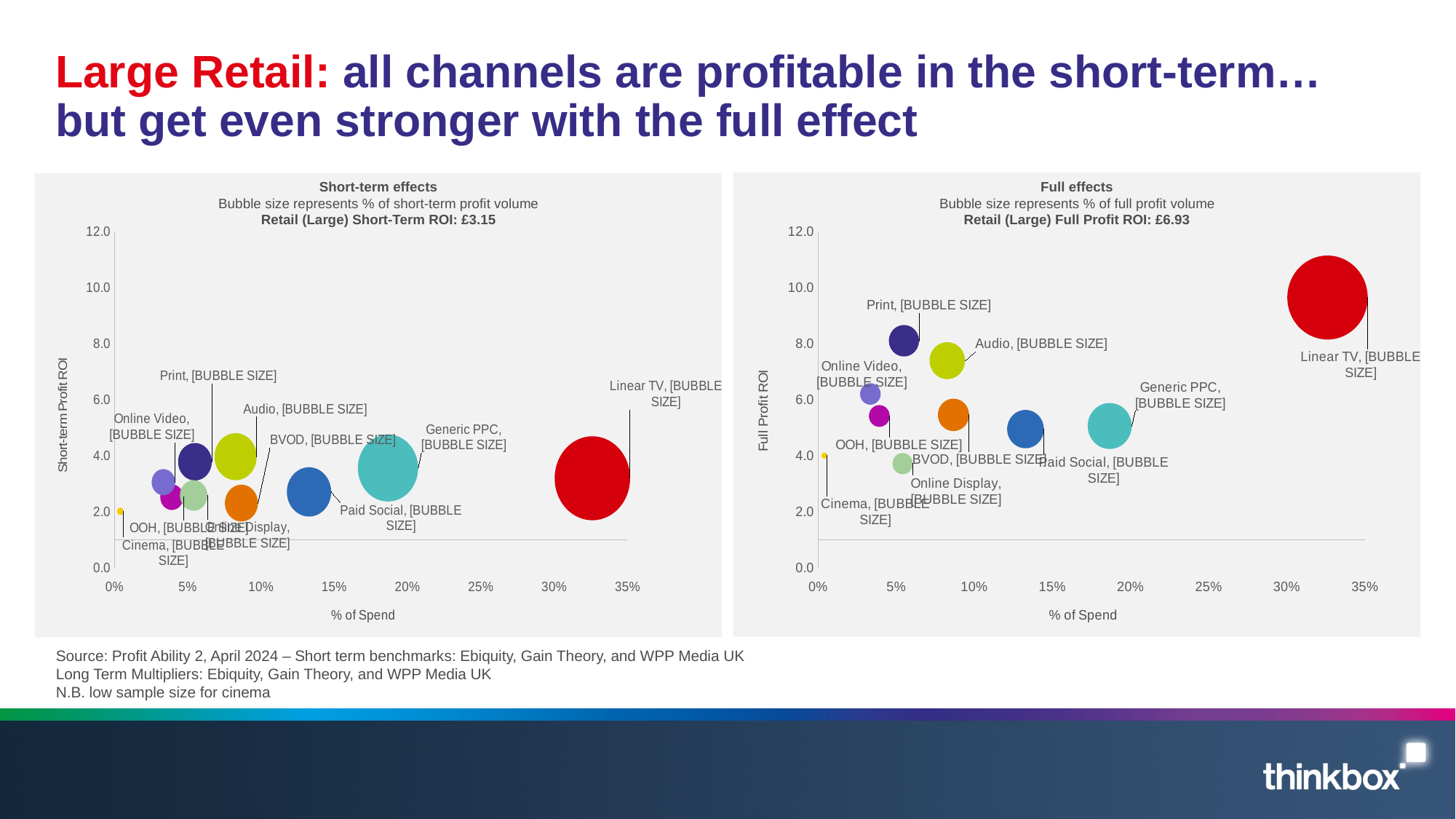
How many channel bubbles are plotted on the Full effects chart? 10 What kind of chart is the Short-term effects chart? Bubble chart On the Full effects chart, is the Full Profit ROI for Audio greater or less than 6.0? greater On the Full effects chart, what is the Retail (Large) Full Profit ROI stated in the chart title? £6.93 On the Short-term effects chart, what is the Retail (Large) Short-Term ROI stated in the chart title? £3.15 On the Short-term effects chart, which channel has the smallest % of Spend? Cinema On the Short-term effects chart, is the Short-term Profit ROI for Paid Social greater or less than 4.0? less On the Full effects chart, which channel has the highest Full Profit ROI? Linear TV On the Full effects chart, which channel has the largest % of Spend? Linear TV On the Full effects chart, which has the higher Full Profit ROI, Linear TV or Generic PPC? Linear TV On the Short-term effects chart, is the Short-term Profit ROI for Linear TV greater or less than 2.0? greater